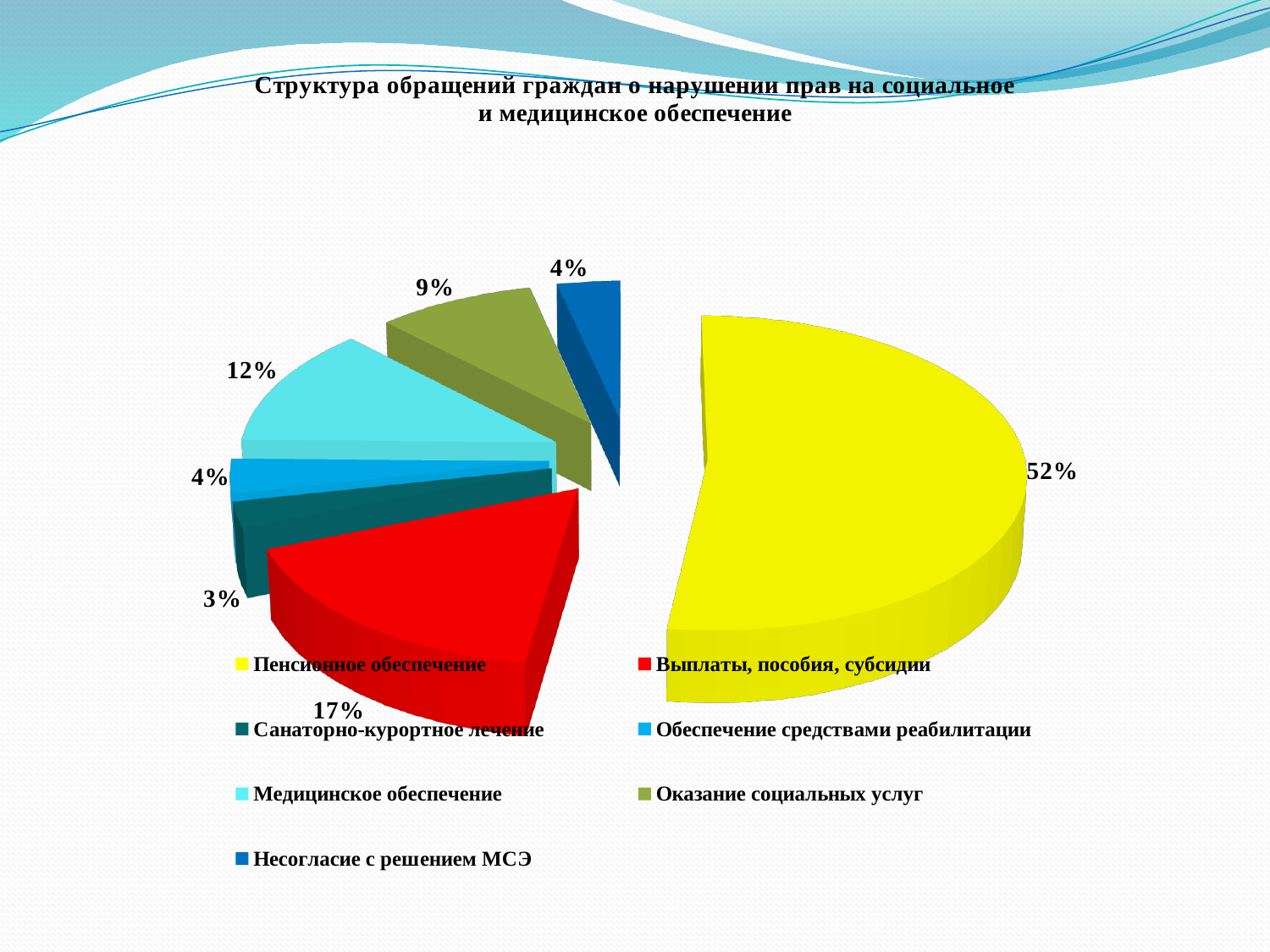
What share of the pie does Санаторно-курортное лечение have? 3% Which category has the largest share of the pie? Пенсионное обеспечение Which has a larger share, Медицинское обеспечение or Оказание социальных услуг? Медицинское обеспечение Which category has the smallest share of the pie? Санаторно-курортное лечение What is the difference between the shares of Пенсионное обеспечение and Выплаты, пособия, субсидии? 35% What share of the pie does Пенсионное обеспечение have? 52% What kind of chart is shown on the slide? pie chart What share of the pie does Оказание социальных услуг have? 9% How many categories does the legend list? 7 What share of the pie does Выплаты, пособия, субсидии have? 17% What share of the pie does Медицинское обеспечение have? 12% What share of the pie does Несогласие с решением МСЭ have? 4%